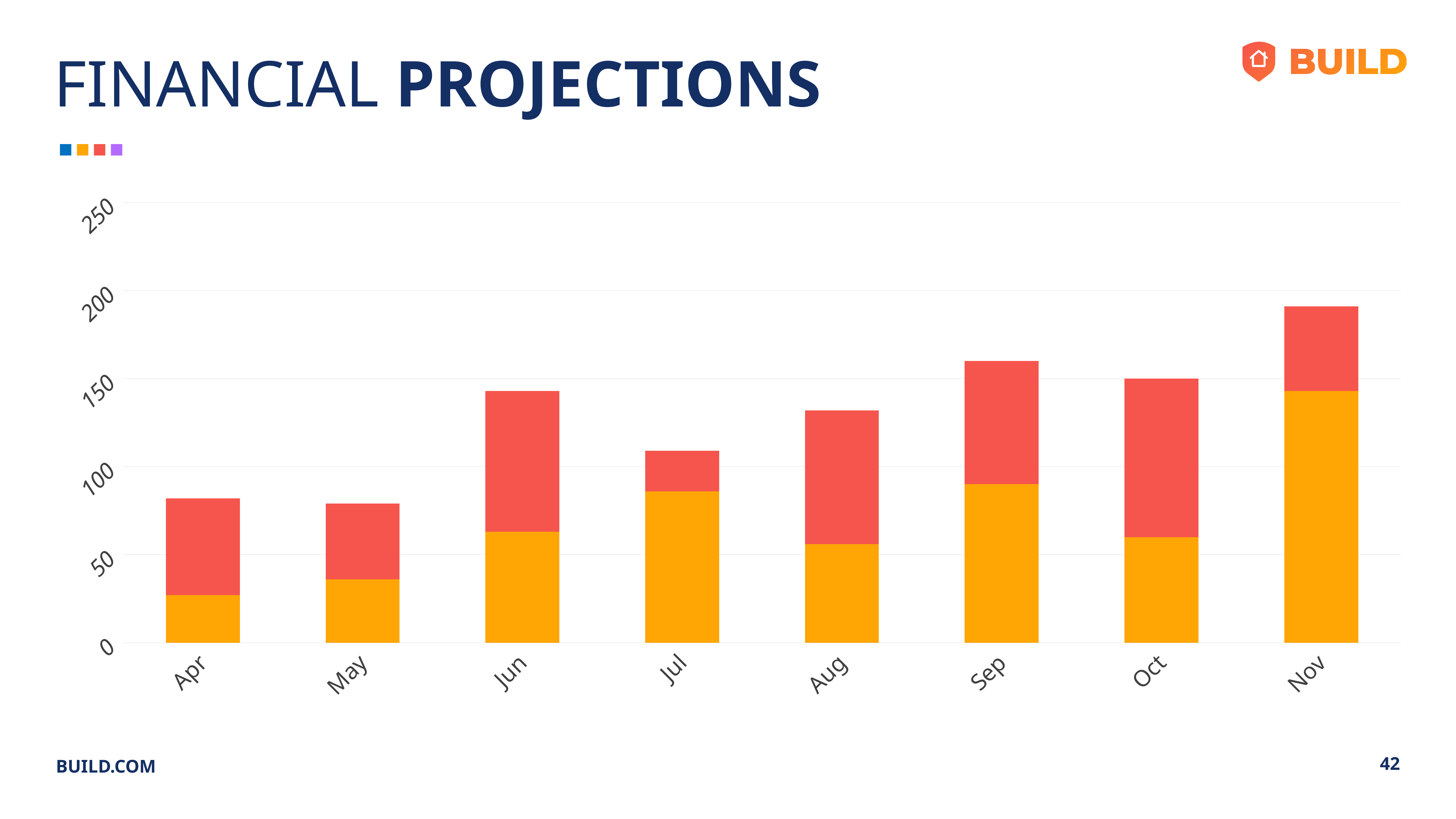
What two colours are used for the segments of each stacked bar? orange and red Is the total value for Sep greater or less than 200? less Do the stacked bar totals generally rise or fall from Apr to Nov? rise Which has the taller stacked bar, Sep or Aug? Sep Is the total value for Nov greater or less than 150? greater Which month has the tallest stacked bar? Nov How many months are shown on the x axis of the chart? 8 Is the total value for Apr greater or less than 100? less What kind of chart is shown on the slide? stacked bar chart Which has the taller stacked bar, Jun or Jul? Jun